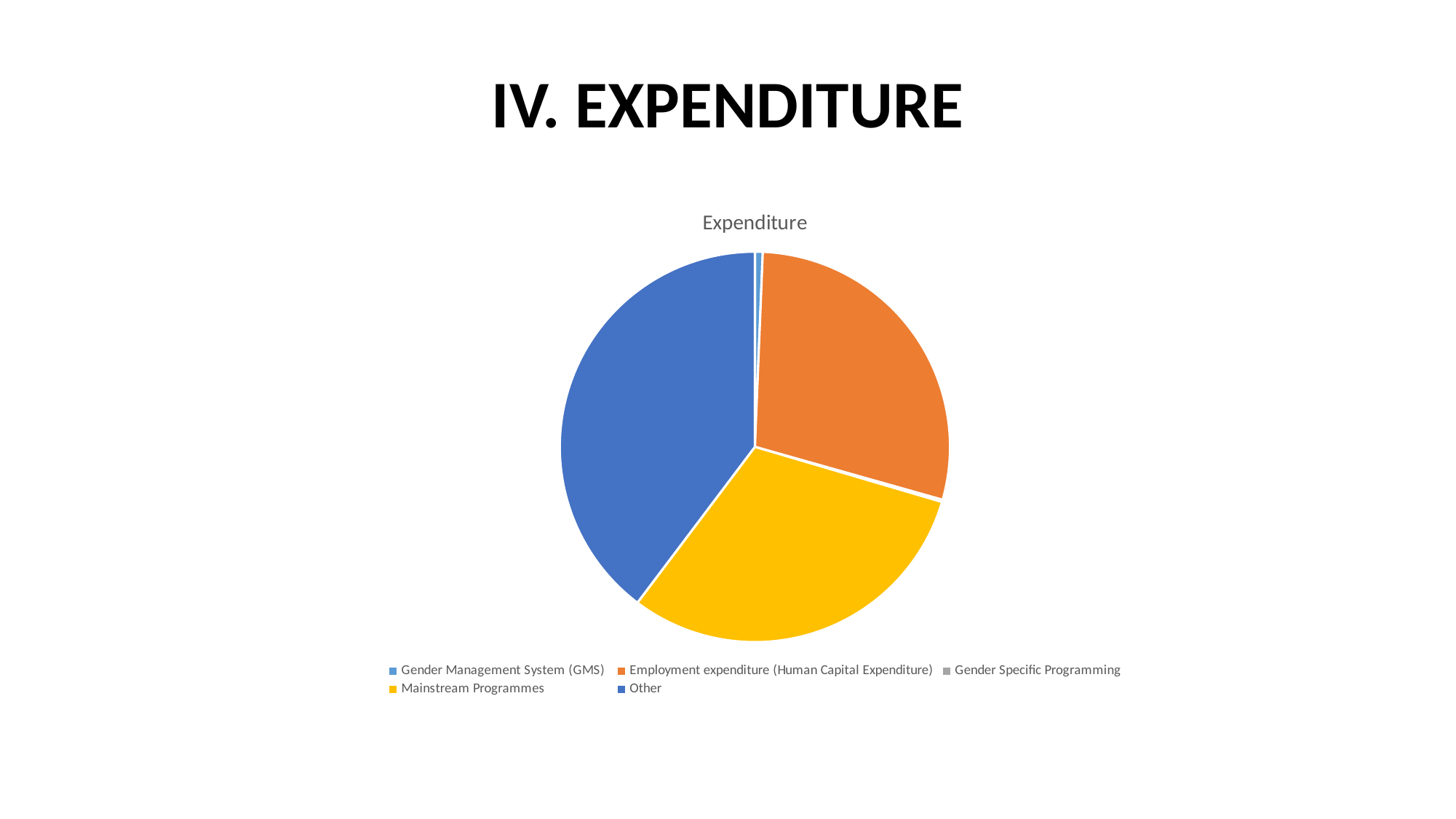
How many categories does the legend of the pie chart list? 5 What is the title of the chart? Expenditure Which slice is larger, Employment expenditure (Human Capital Expenditure) or Gender Management System (GMS)? Employment expenditure (Human Capital Expenditure) Which slice is larger, Other or Employment expenditure (Human Capital Expenditure)? Other What colour is the slice for Mainstream Programmes? Yellow What kind of chart is shown on the slide? Pie chart Which slice is larger, Mainstream Programmes or Gender Management System (GMS)? Mainstream Programmes Which category has the largest slice of the pie? Other